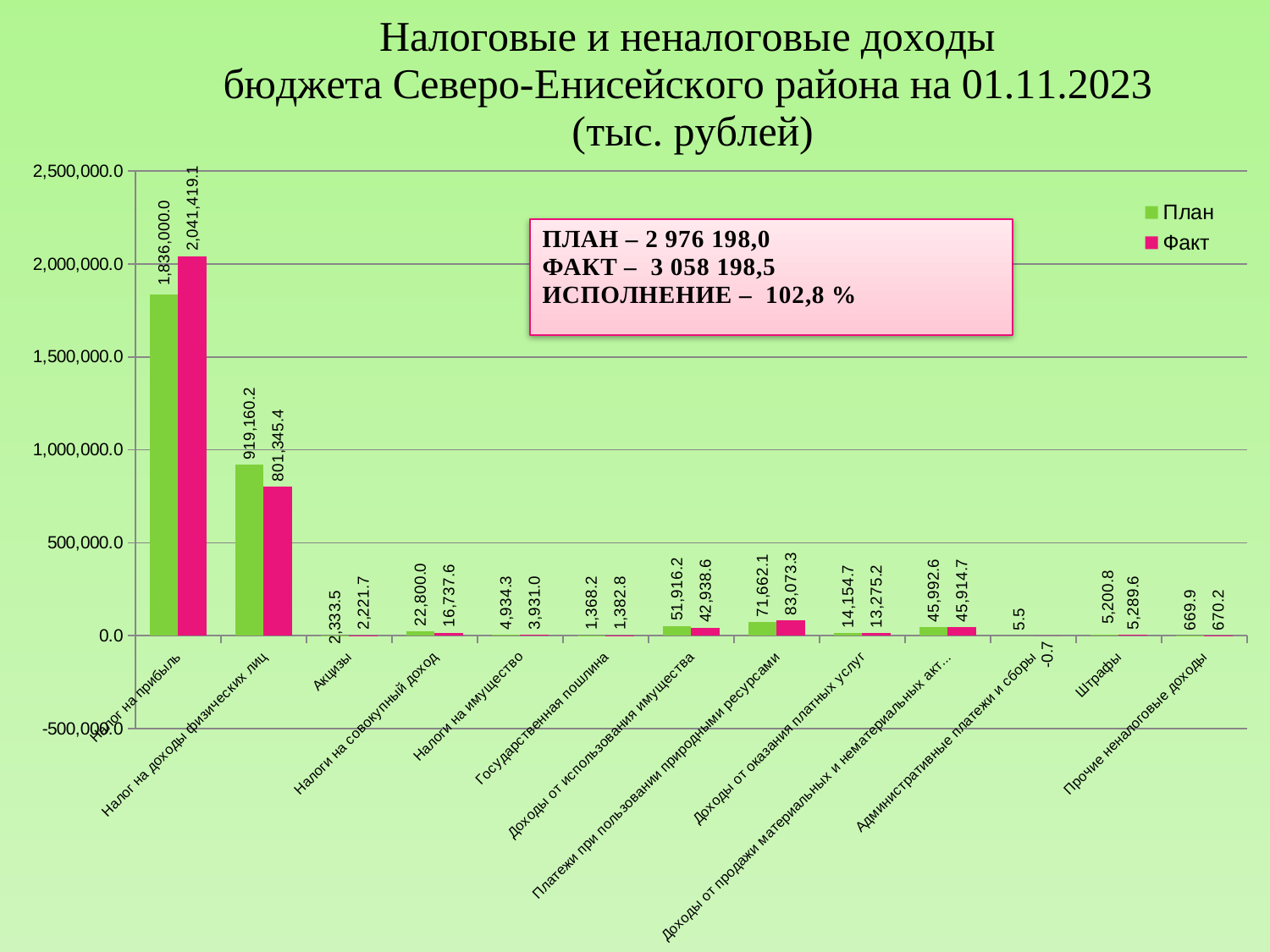
What is the Факт value for Налог на доходы физических лиц? 801,345.4 How many series does the legend list? 2 What kind of chart is shown on the slide? Bar chart For Налог на доходы физических лиц, which is larger: План or Факт? План Which category has the lowest Факт value? Административные платежи и сборы Which category has the highest Факт value? Налог на прибыль How many categories are shown on the x axis? 13 What is the План value for Штрафы? 5,200.8 What is the difference between the Факт and План values for Налог на прибыль? 205,419.1 What is the План value for Налог на прибыль? 1,836,000.0 What is the Факт value for Платежи при пользовании природными ресурсами? 83,073.3 What is the difference between the План and Факт values for Налоги на совокупный доход? 6,062.4